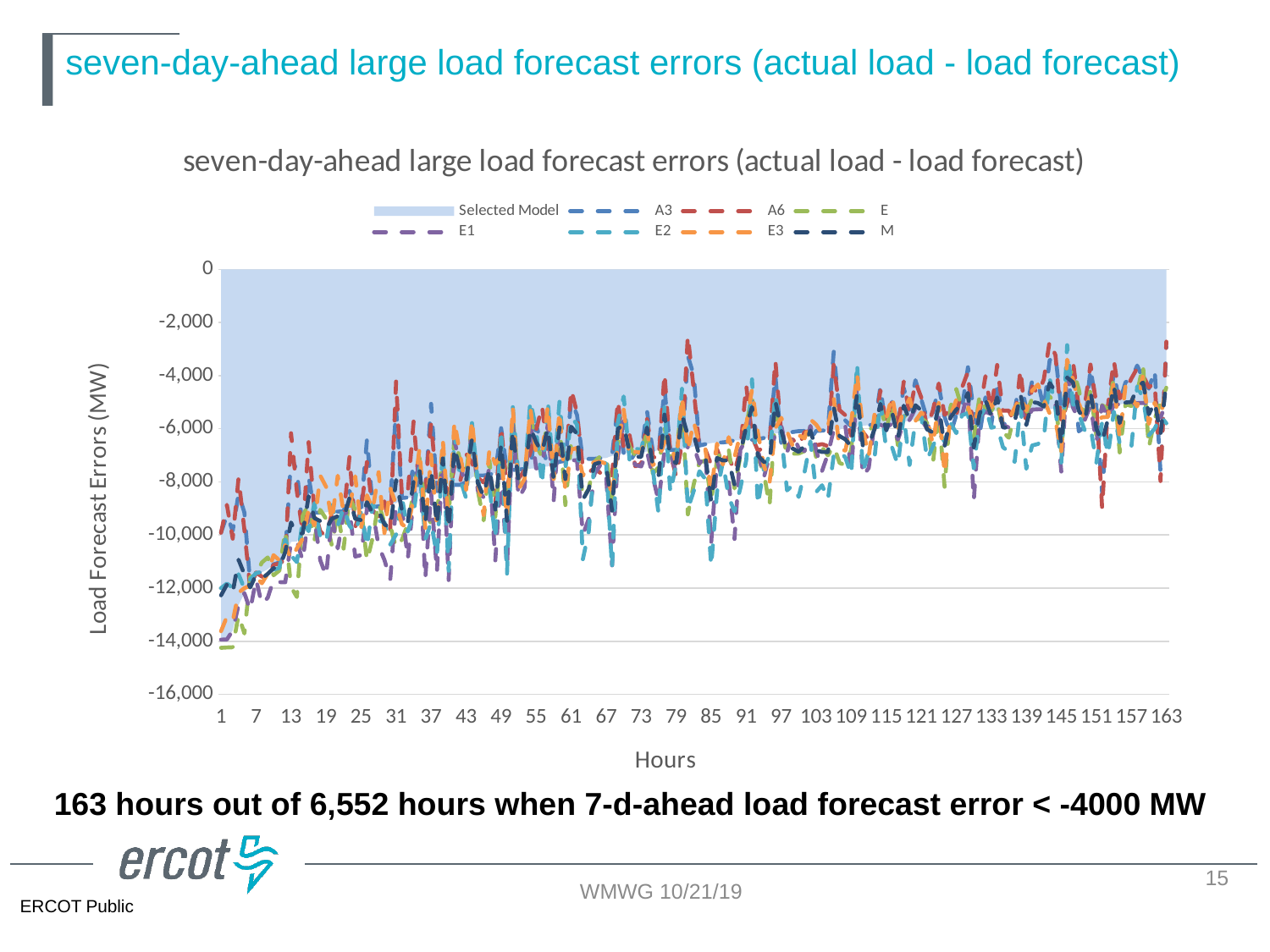
What is the label of the y axis of the chart? Load Forecast Errors (MW) How many hours are plotted along the x axis of the chart? 163 What kind of chart is shown on the slide? area and line chart Is the value for series E at hour 1 greater or less than -12,000? less How many series does the chart's legend list? 8 Do the load forecast error values generally rise or fall as the hours increase along the x axis? rise What is the title of the chart? seven-day-ahead large load forecast errors (actual load - load forecast) Is the value for series A3 at hour 163 greater or less than -10,000? greater Is the value for series A6 at hour 163 greater or less than -8,000? greater